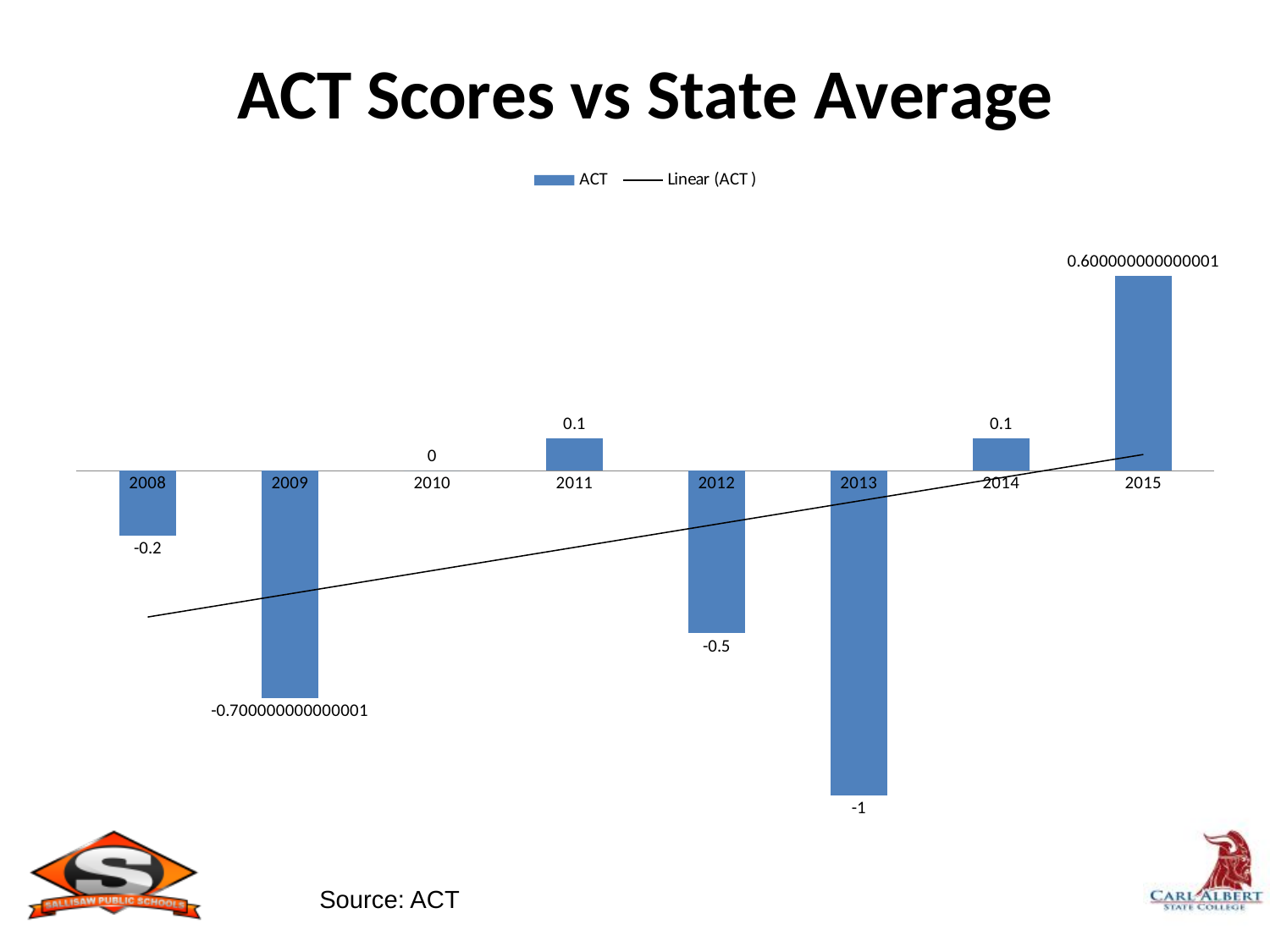
Which year has the lowest value? 2013 How many entries does the legend list? 2 What kind of chart is shown? Bar chart Which is larger, the value for 2012 or the value for 2014? 2014 What is the value for 2013? -1 How many years are shown on the x axis? 8 What is the value for 2008? -0.2 What is the value for 2015? 0.600000000000001 What is the difference between the values for 2012 and 2013? 0.5 Which year has the highest value? 2015 What is the value for 2010? 0 What is the difference between the values for 2011 and 2008? 0.3